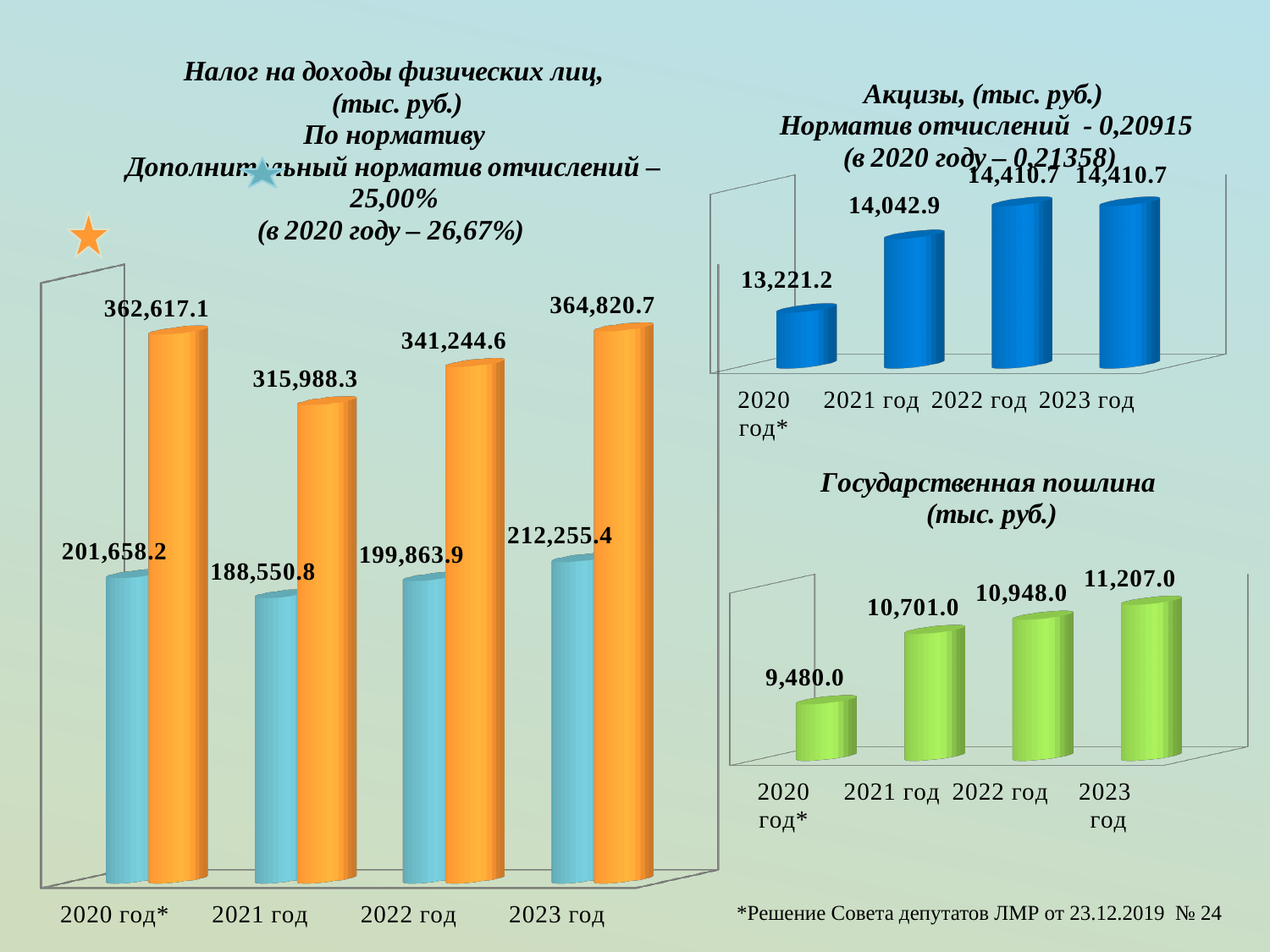
In the 'Налог на доходы физических лиц' chart, what is the value of the blue bar for 2021 год? 188,550.8 In the 'Налог на доходы физических лиц' chart, which is larger: the blue bar for 2020 год* or the blue bar for 2022 год? 2020 год* In the 'Государственная пошлина' chart, which year has the lowest value? 2020 год* In the 'Акцизы' chart, what is the difference between the values for 2021 год and 2020 год*? 821.7 In the 'Государственная пошлина' chart, what is the value for 2023 год? 11,207.0 How many years are shown on the x axis of the 'Акцизы' chart? 4 In the 'Государственная пошлина' chart, do the values rise or fall from 2020 год* to 2023 год? rise In the 'Государственная пошлина' chart, what is the difference between the values for 2023 год and 2022 год? 259.0 What kind of chart is the 'Государственная пошлина' chart? bar chart In the 'Акцизы' chart, what is the value for 2021 год? 14,042.9 In the 'Налог на доходы физических лиц' chart, which year has the highest orange bar? 2023 год In the 'Налог на доходы физических лиц' chart, what is the value of the orange bar for 2022 год? 341,244.6